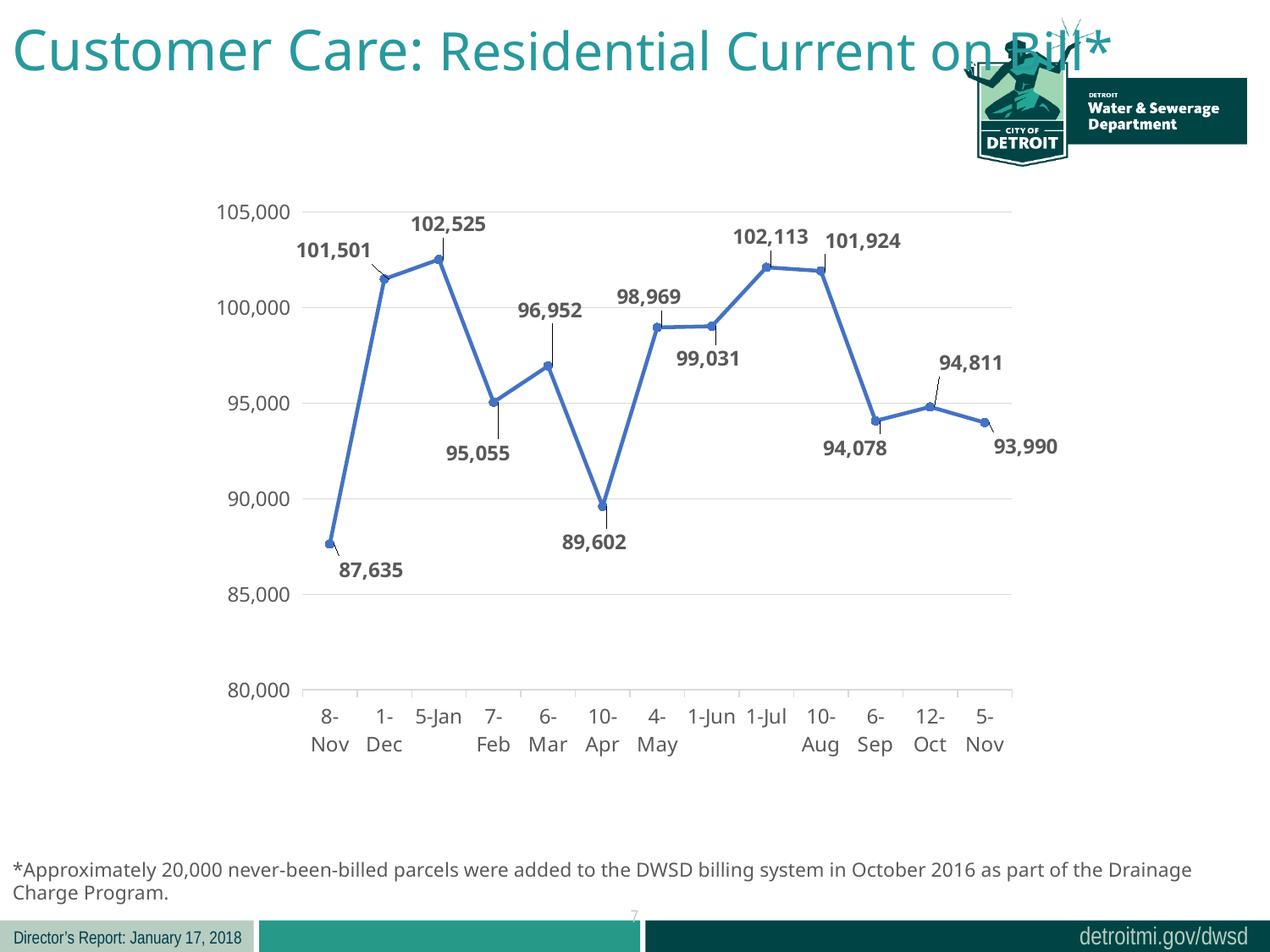
Is the value for 10-Aug greater or less than 100,000? greater What is the value for 1-Jul? 102,113 What is the value for 10-Apr? 89,602 What type of chart is shown on the slide? Line chart Which is larger, the value for 6-Mar or the value for 7-Feb? 6-Mar Do the values rise or fall from 10-Aug to 6-Sep? Fall What is the value for 8-Nov? 87,635 Which date has the highest value? 5-Jan Which date has the lowest value? 8-Nov How many data points are plotted on the chart? 13 What is the value for 5-Jan? 102,525 What is the difference between the values for 1-Dec and 8-Nov? 13,866